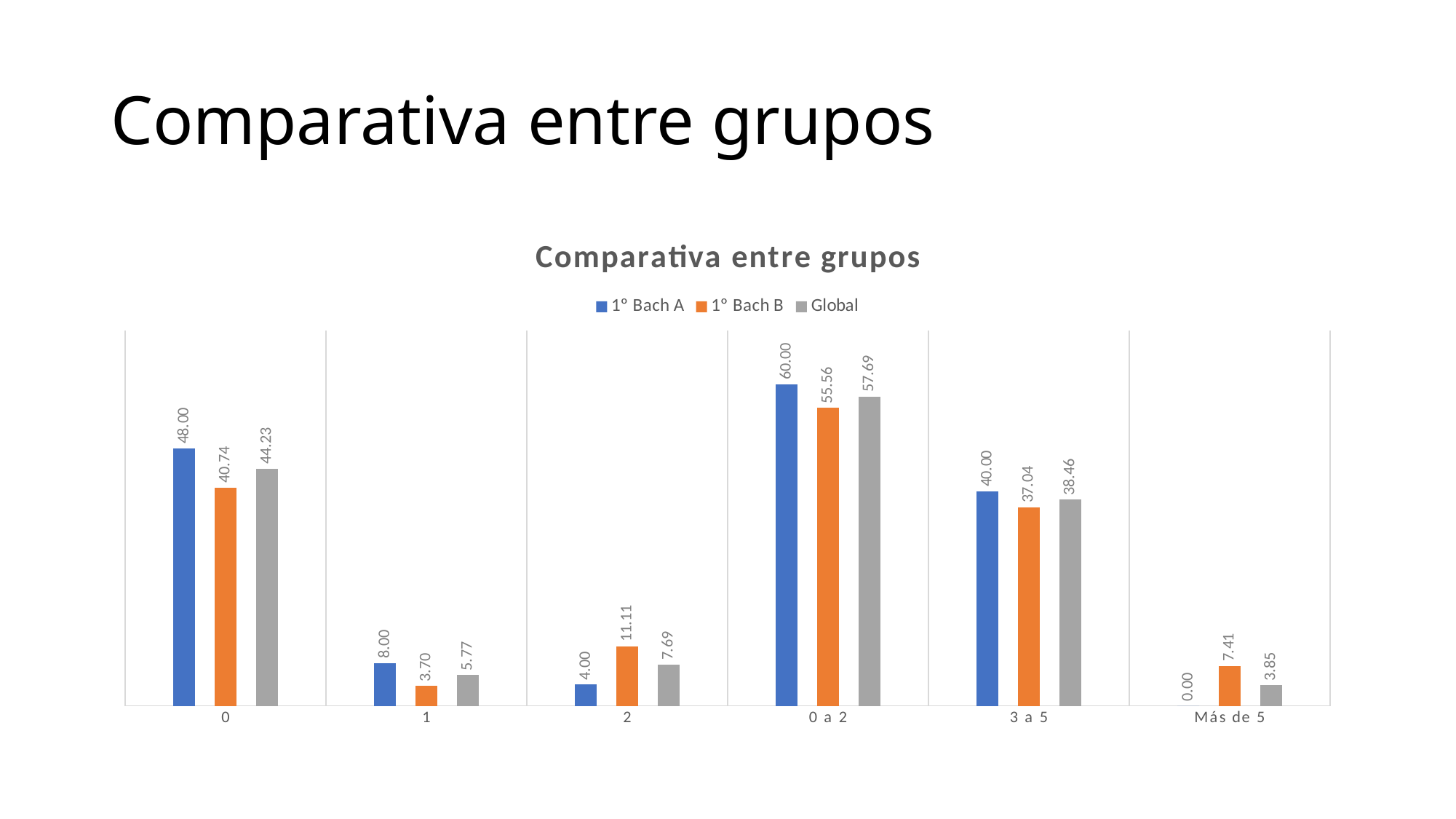
How many series does the legend list? 3 Which colour represents the Global series? Grey What is the value for Global in the category "0 a 2"? 57.69 How many categories are shown on the x axis? 6 What kind of chart is shown on the slide? Bar chart What is the title of the chart? Comparativa entre grupos Which category has the highest value for 1° Bach A? 0 a 2 What is the value for 1° Bach A in the category "0"? 48.00 In the category "2", which series has the larger value, 1° Bach A or 1° Bach B? 1° Bach B What is the difference between the 1° Bach A and 1° Bach B values in the category "0 a 2"? 4.44 What is the value for 1° Bach B in the category "Más de 5"? 7.41 Which category has the lowest value for 1° Bach A? Más de 5